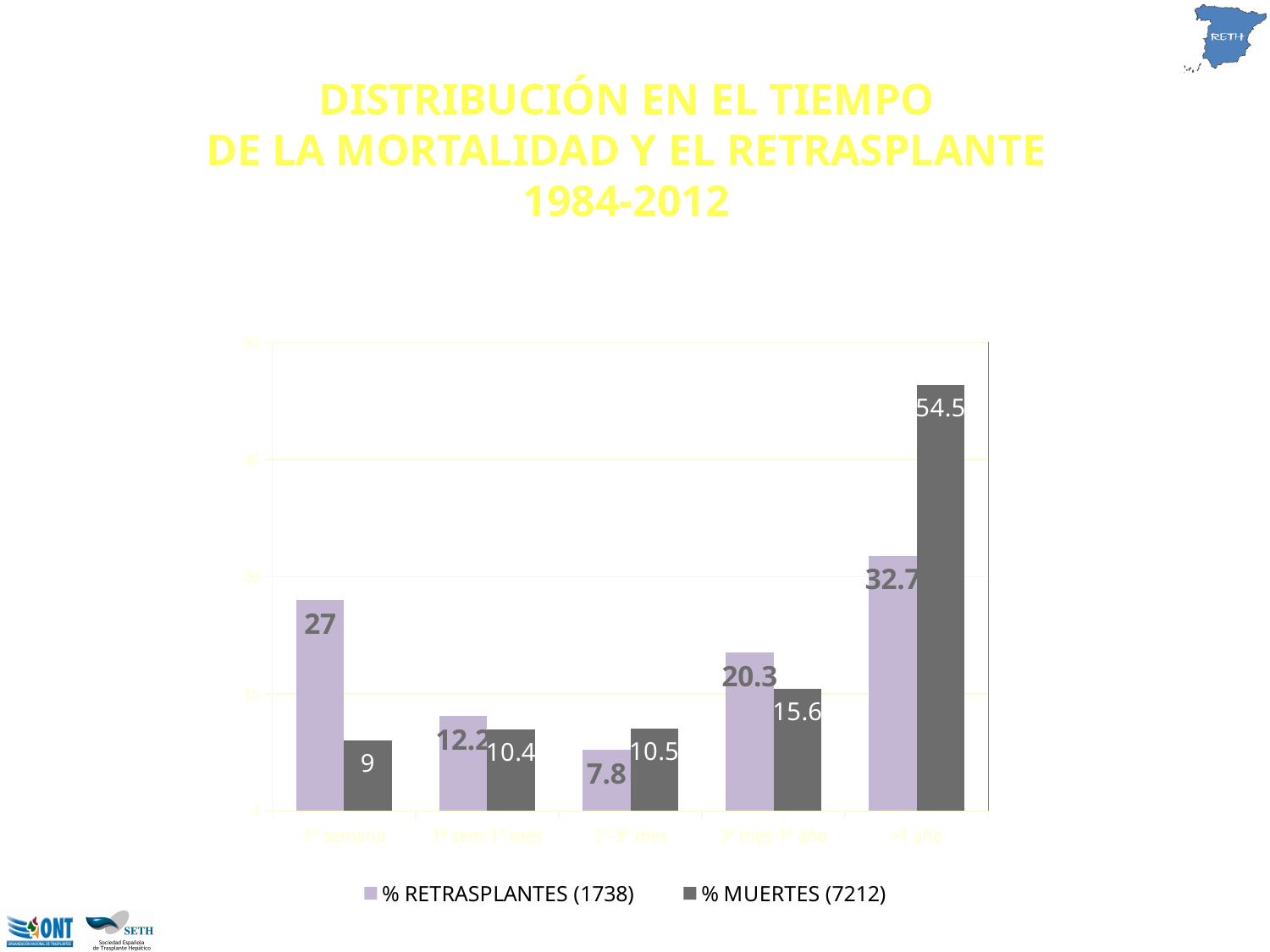
What is the difference between % MUERTES (7212) and % RETRASPLANTES (1738) for the >1 año category? 21.8 What is the value of % RETRASPLANTES (1738) for the 1ª semana category? 27 Which category has the lowest value for % RETRASPLANTES (1738)? 1º-3º mes What is the difference between % RETRASPLANTES (1738) for 1ª semana and for 1ª sem-1º mes? 14.8 What is the value of % RETRASPLANTES (1738) for the 3º mes-1º año category? 20.3 What type of chart is shown on the slide? bar chart How many series does the legend list? 2 How many categories are shown on the x axis? 5 Which category has the highest value for % MUERTES (7212)? >1 año For the 1ª semana category, which is larger: % RETRASPLANTES (1738) or % MUERTES (7212)? % RETRASPLANTES (1738) What is the value of % MUERTES (7212) for the >1 año category? 54.5 What are the two series named in the legend? % RETRASPLANTES (1738) and % MUERTES (7212)